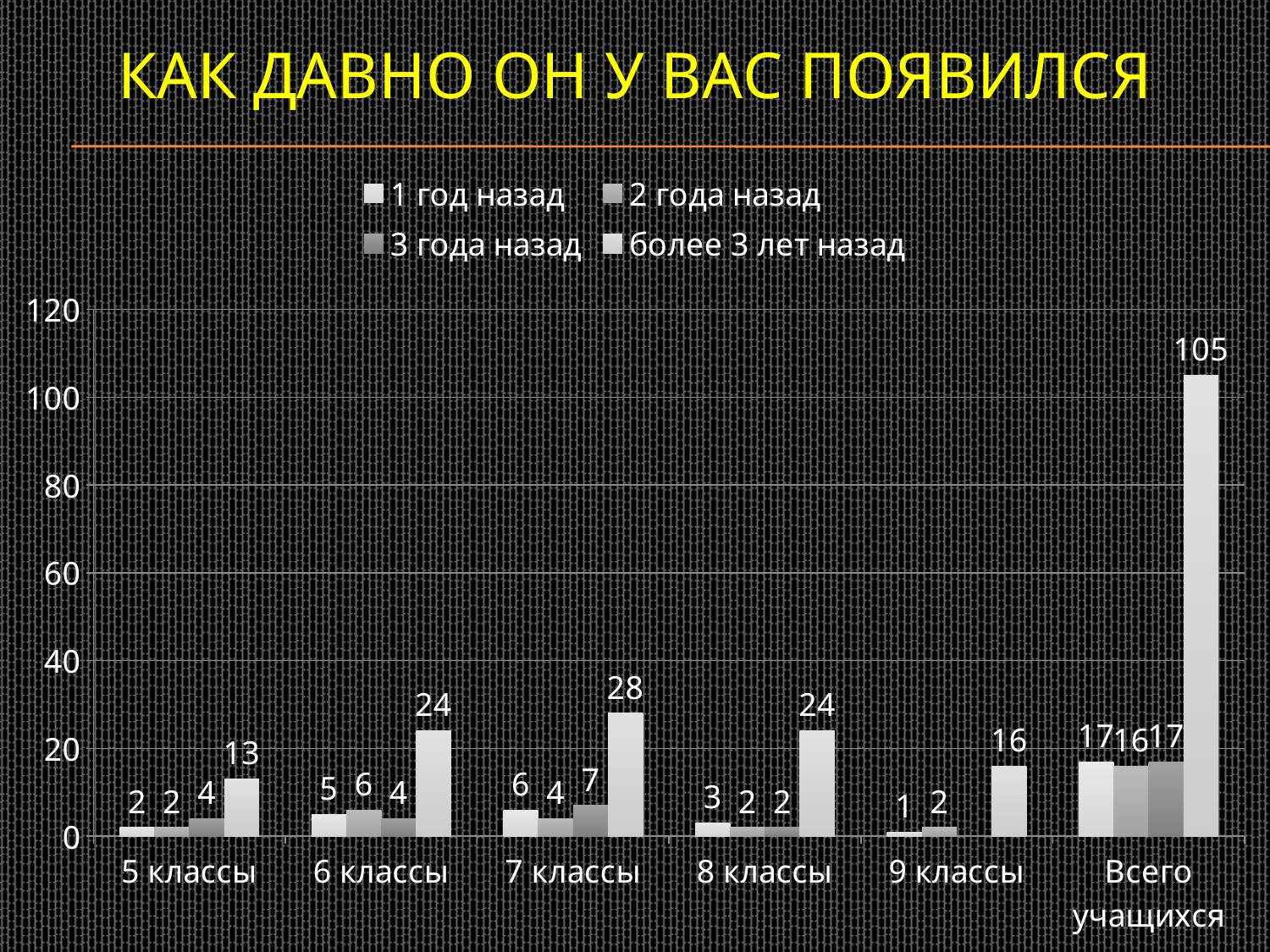
Among the class categories (excluding 'Всего учащихся'), which has the lowest value for 'более 3 лет назад'? 5 классы What is the value for '2 года назад' in the '6 классы' category? 6 What is the difference between the 'более 3 лет назад' values for '7 классы' and '8 классы'? 4 How many series does the legend list? 4 What is the value for 'более 3 лет назад' in the '7 классы' category? 28 What kind of chart is shown on the slide? bar chart Which category has the highest value for the 'более 3 лет назад' series? Всего учащихся What is the value for '1 год назад' in the 'Всего учащихся' category? 17 How many categories are shown on the x axis? 6 What is the title of the chart? КАК ДАВНО ОН У ВАС ПОЯВИЛСЯ Is the value for 'более 3 лет назад' in 'Всего учащихся' greater or less than 100? greater Which is larger: the '3 года назад' value for '7 классы' or for '6 классы'? 7 классы